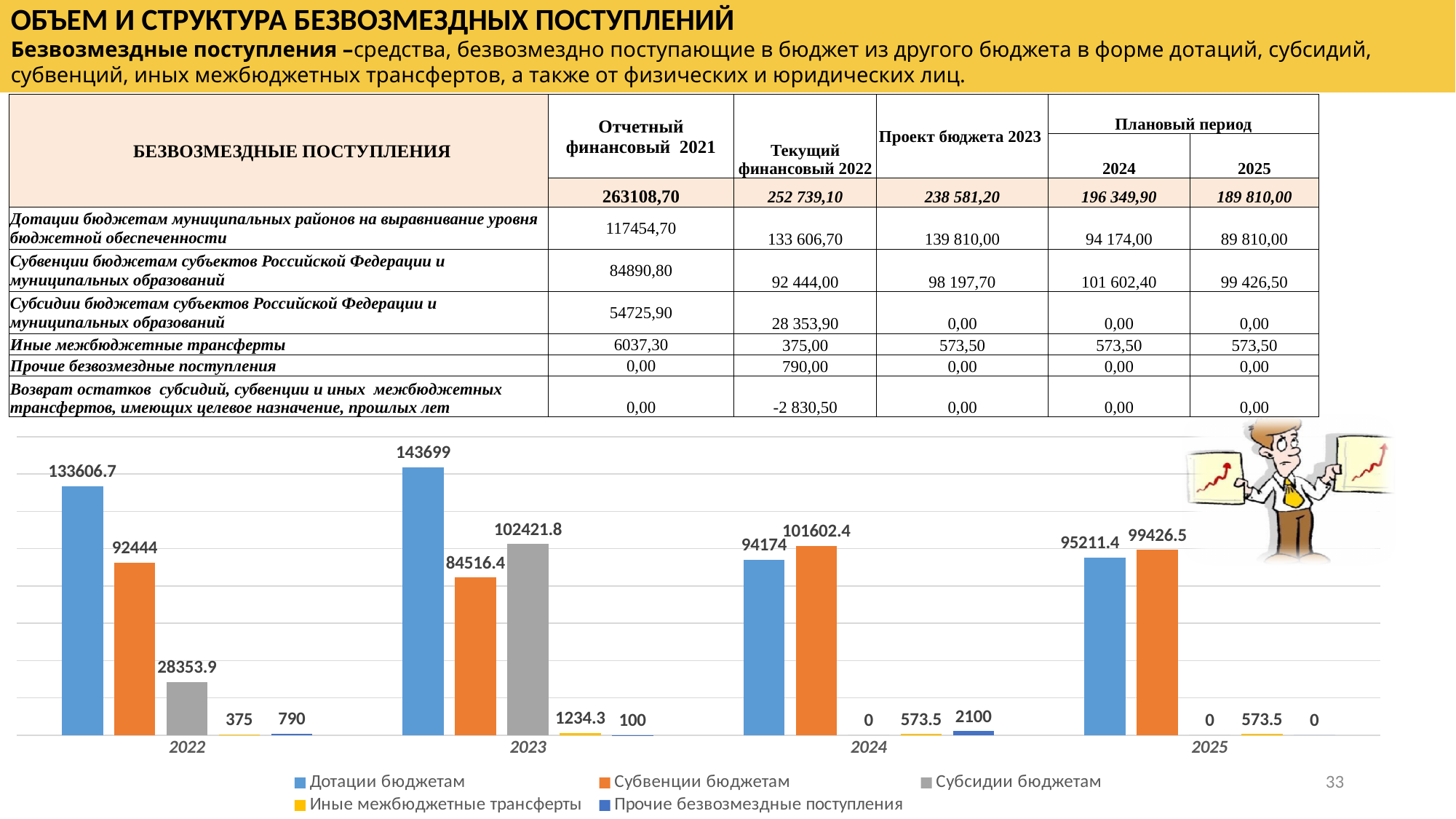
In the chart, what is the value of Иные межбюджетные трансферты for 2023? 1234.3 In the chart, what is the value of Дотации бюджетам for 2023? 143699 How many year categories are shown on the x axis of the chart? 4 In the chart, what is the value of Субвенции бюджетам for 2025? 99426.5 In which year does Дотации бюджетам reach its highest value in the chart? 2023 In the chart, what is the value of Прочие безвозмездные поступления for 2024? 2100 Which colour represents Субсидии бюджетам in the chart legend? grey In the chart, what is the difference between Дотации бюджетам in 2023 and in 2022? 10092.3 In the chart, what is the value of Субсидии бюджетам for 2022? 28353.9 In the chart, which is larger for 2024: Дотации бюджетам or Субвенции бюджетам? Субвенции бюджетам How many series does the chart legend list? 5 What kind of chart is shown at the bottom of the slide? bar chart